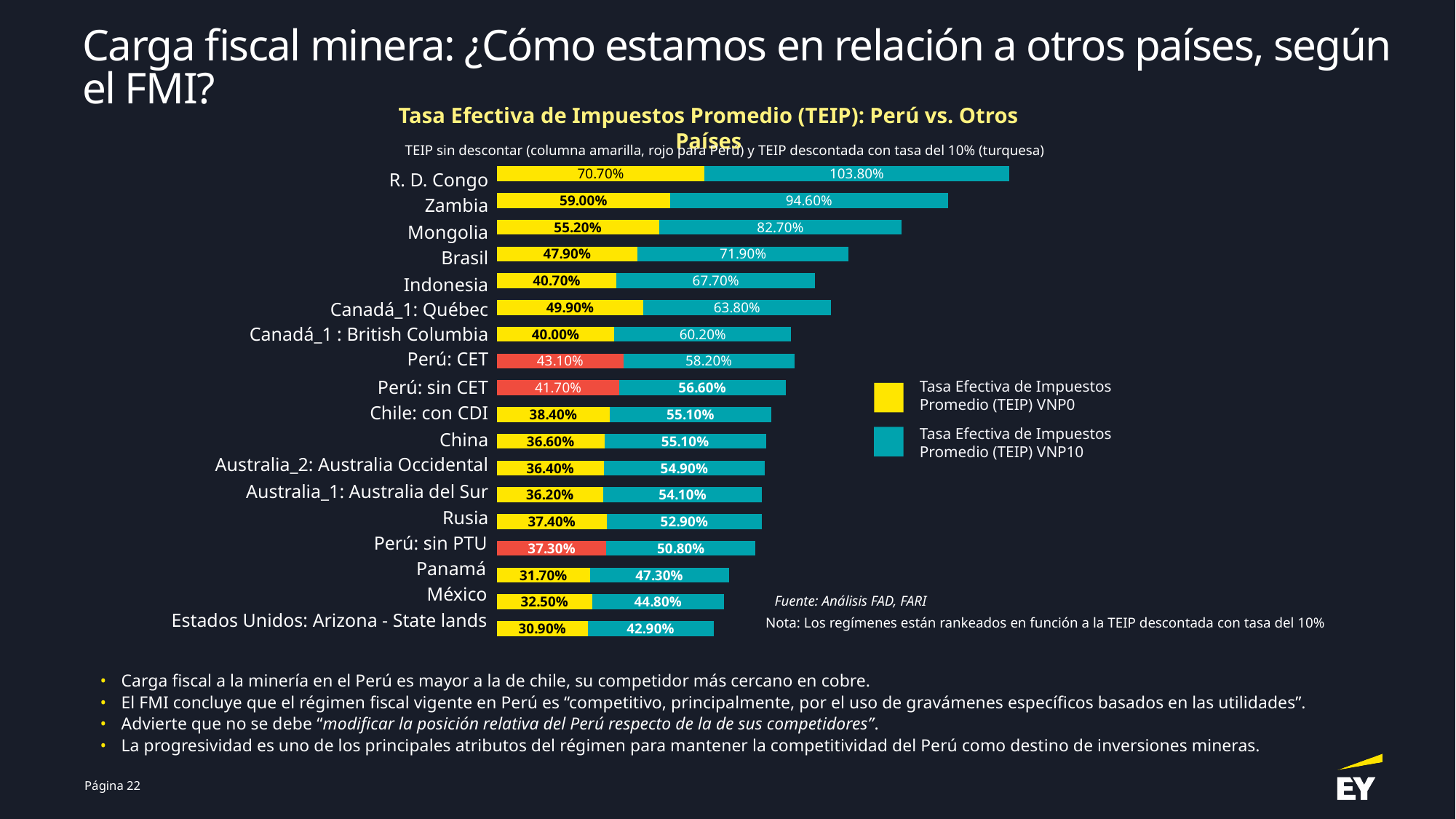
What is the Tasa Efectiva de Impuestos Promedio (TEIP) VNP10 value for R. D. Congo? 103.80% How many series does the legend list? 2 What is the TEIP VNP0 value for Perú: CET? 43.10% Which regime has the lowest TEIP VNP0 value? Estados Unidos: Arizona - State lands What is the difference between the TEIP VNP10 values of Perú: CET and Chile: con CDI? 3.10 percentage points How many regimes (categories) are shown in the chart? 18 Which regime has the highest TEIP VNP10 value? R. D. Congo What is the TEIP VNP10 value for Chile: con CDI? 55.10% What is the total of the stacked bar for R. D. Congo? 174.50% What is the TEIP VNP0 value for Zambia? 59.00% Which has a larger TEIP VNP0 value, Brasil or Canadá_1: Québec? Canadá_1: Québec What kind of chart is shown on the slide? Stacked bar chart